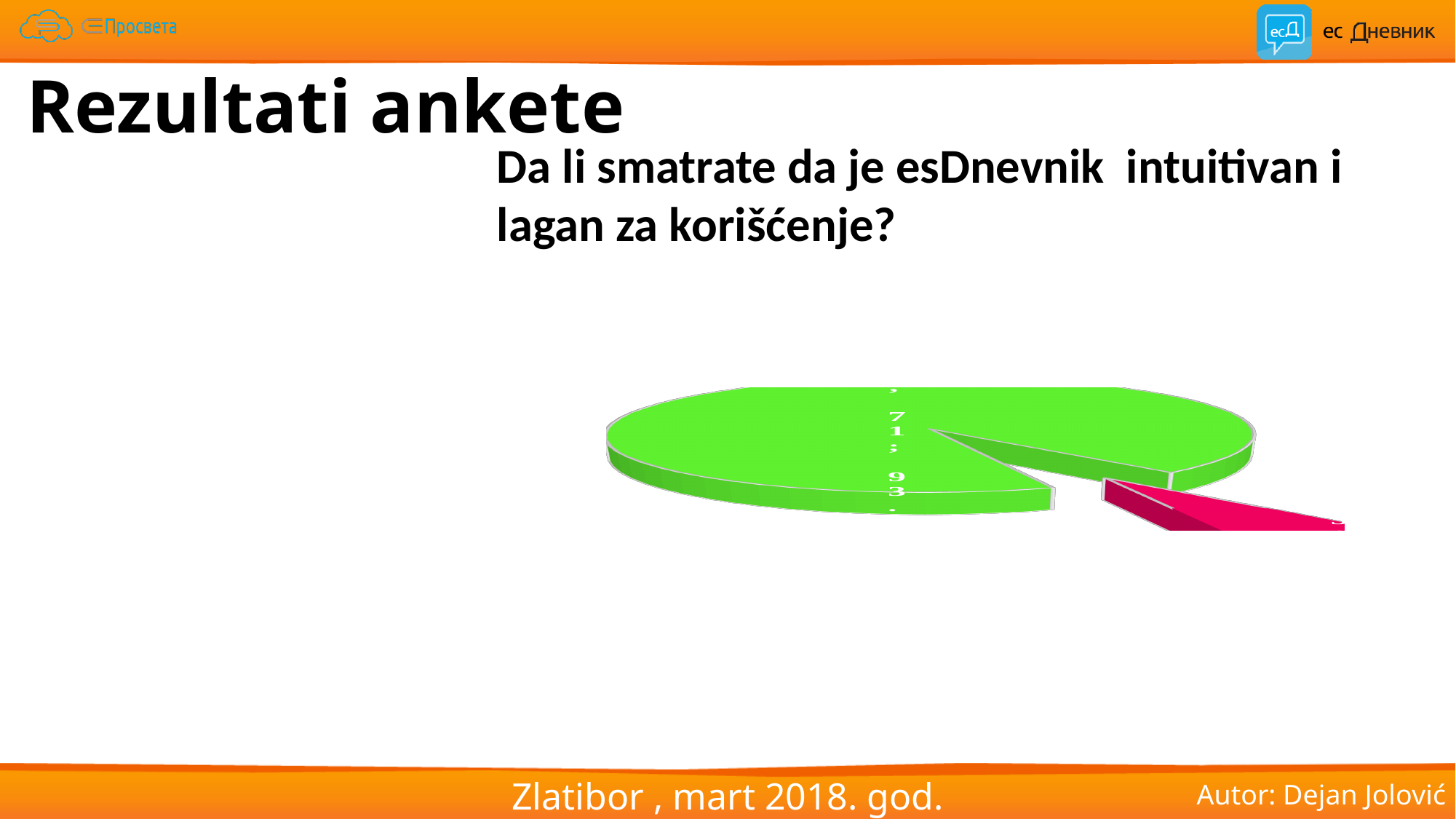
What two colours are used for the slices of the pie chart? green and pink What kind of chart is shown on the slide? pie chart Which colour is the smallest slice of the pie chart? pink Is the green slice of the pie chart greater or less than half of the pie? greater Which slice of the pie chart is larger, the green one or the pink one? the green one Which colour is the largest slice of the pie chart? green What question does the pie chart on the slide present results for? Da li smatrate da je esDnevnik intuitivan i lagan za korišćenje? How many slices does the pie chart have? 2